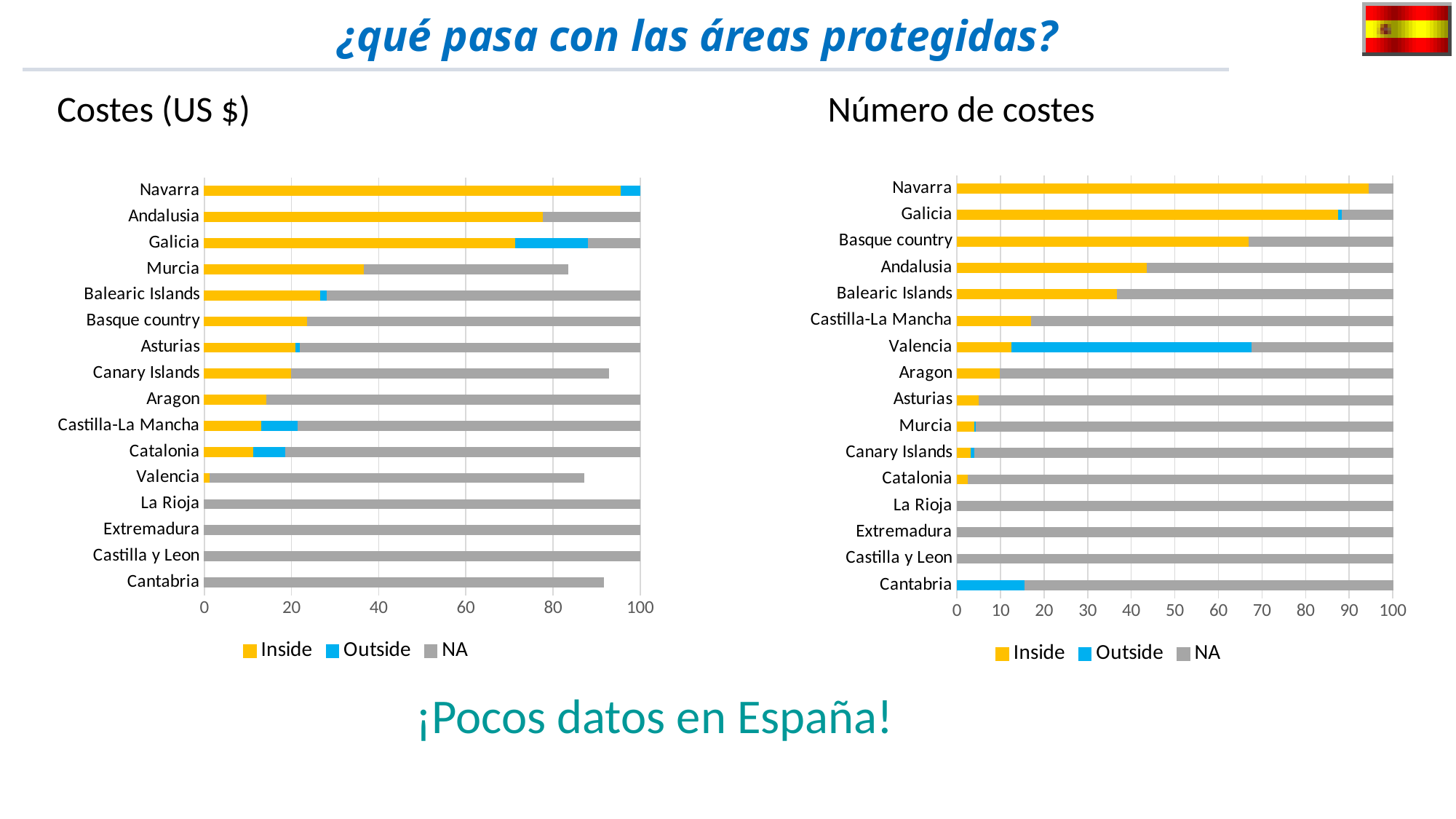
In the 'Costes (US $)' chart, is the Inside value for Galicia greater or less than 60? greater In the 'Número de costes' chart, is the Inside value for Basque country greater or less than 60? greater In the 'Número de costes' chart, which region has the largest Inside segment? Navarra How many series does the legend of the 'Costes (US $)' chart list? 3 In the 'Costes (US $)' chart, which region has a larger Inside segment, Andalusia or Galicia? Andalusia What kind of chart is the 'Costes (US $)' chart on the left? Stacked bar chart In the 'Número de costes' chart, which region has a larger Inside segment, Galicia or Basque country? Galicia In the 'Número de costes' chart, is the Outside segment for Cantabria greater or less than 20? less How many regions are listed on the 'Número de costes' chart on the right? 16 What are the three legend entries of the 'Número de costes' chart? Inside, Outside, NA In the 'Costes (US $)' chart, which region has the largest Inside segment? Navarra